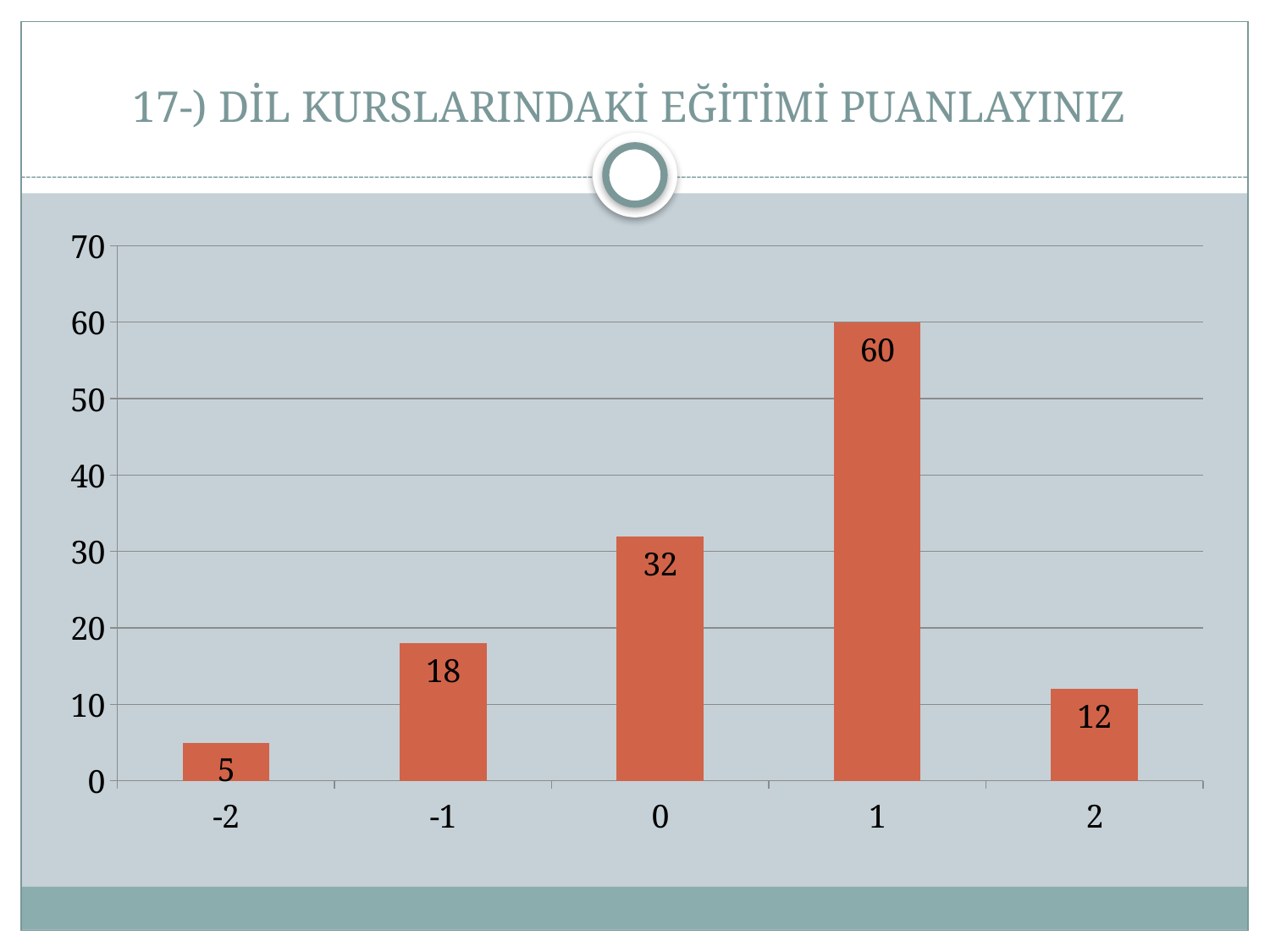
Which is larger, the value for category -1 or the value for category 2? -1 What is the title of the slide? 17-) DİL KURSLARINDAKİ EĞİTİMİ PUANLAYINIZ What is the difference between the values for category 1 and category 0? 28 Which category has the lowest value? -2 What is the value for category -2? 5 What is the difference between the values for category -1 and category 2? 6 What kind of chart is shown on the slide? bar chart What is the value for category 0? 32 What is the value for category 2? 12 Which category has the highest value? 1 What is the value for category 1? 60 How many categories are shown on the x axis? 5